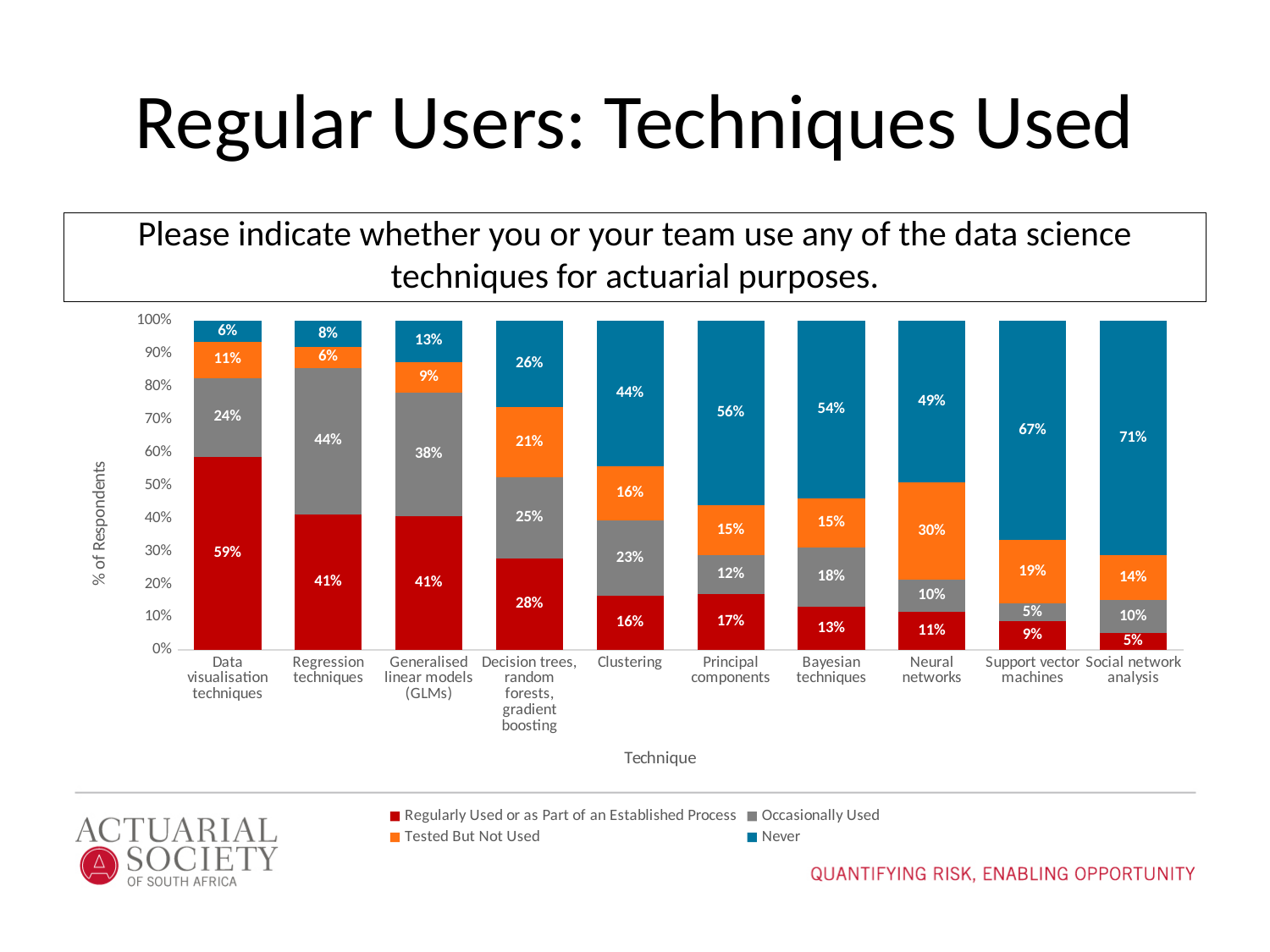
What is the difference between the Never percentages for Support vector machines and Clustering? 23% Which technique has the lowest percentage for Regularly Used or as Part of an Established Process? Social network analysis Which has a larger Tested But Not Used percentage, Decision trees, random forests, gradient boosting or Generalised linear models (GLMs)? Decision trees, random forests, gradient boosting What percentage of respondents said they Never use Social network analysis? 71% What kind of chart is shown on the slide? Stacked bar chart What percentage of respondents said Regression techniques are Occasionally Used? 44% What percentage of respondents said Neural networks were Tested But Not Used? 30% Which technique has the highest percentage for Never? Social network analysis How many series does the legend list? 4 What percentage of respondents said Data visualisation techniques are Regularly Used or as Part of an Established Process? 59% How many techniques are shown on the x axis of the chart? 10 What is the label of the y axis of the chart? % of Respondents